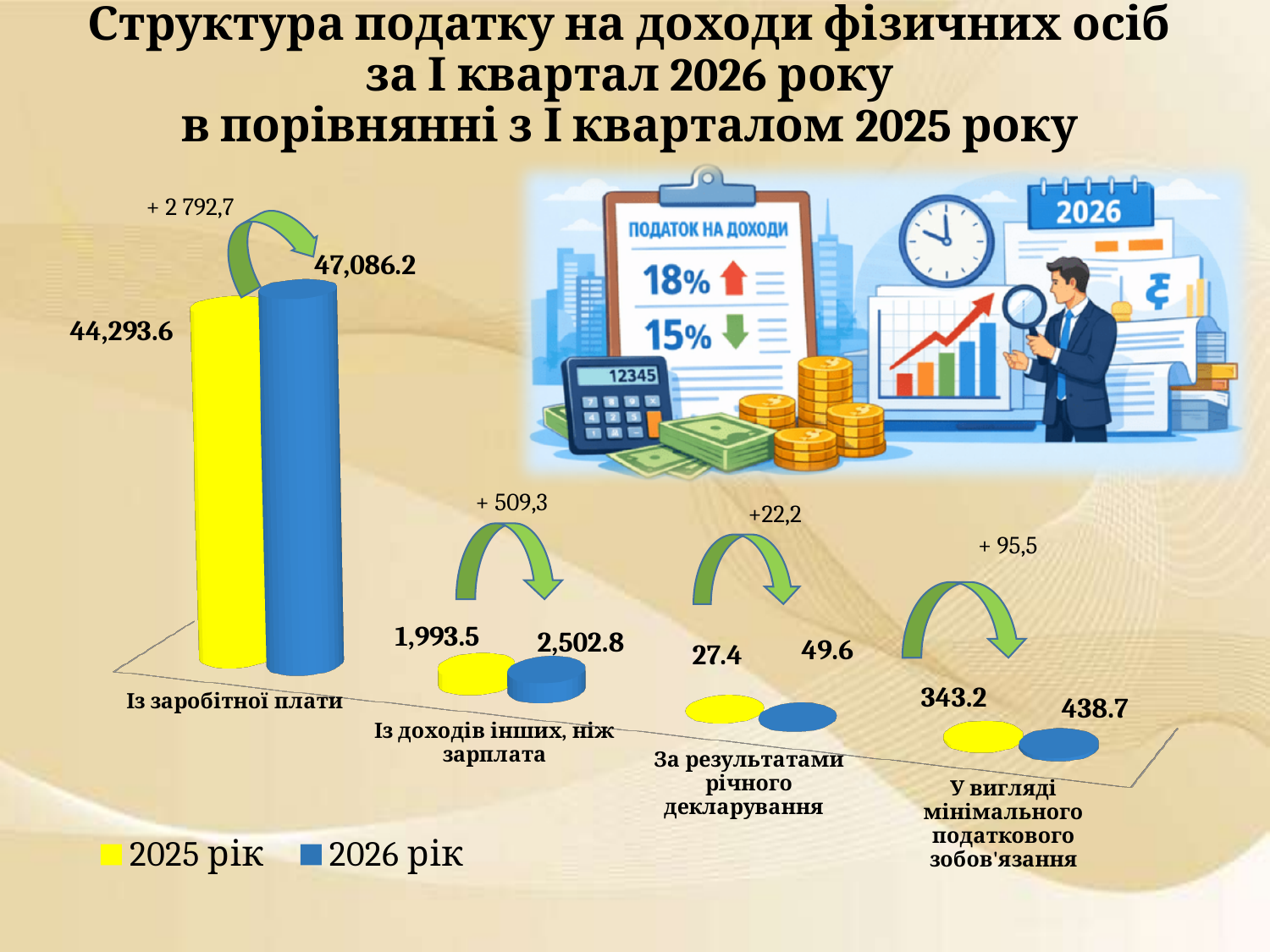
Which category has the highest value in the 2026 рік series? Із заробітної плати What is the value for 'За результатами річного декларування' in the 2025 рік series? 27.4 Which category has the lowest value in the 2025 рік series? За результатами річного декларування How many series does the legend list? 2 Which is larger for 'У вигляді мінімального податкового зобов'язання': the 2025 рік value or the 2026 рік value? 2026 рік What is the value for 'У вигляді мінімального податкового зобов'язання' in the 2026 рік series? 438.7 Which colour represents the 2025 рік series in the legend? yellow What is the value for 'Із заробітної плати' in the 2026 рік series? 47,086.2 What is the value for 'Із заробітної плати' in the 2025 рік series? 44,293.6 How many categories are shown on the x axis of the chart? 4 What is the difference between the 2026 рік and 2025 рік values for 'Із доходів інших, ніж зарплата'? 509.3 What kind of chart is shown on the slide? bar chart